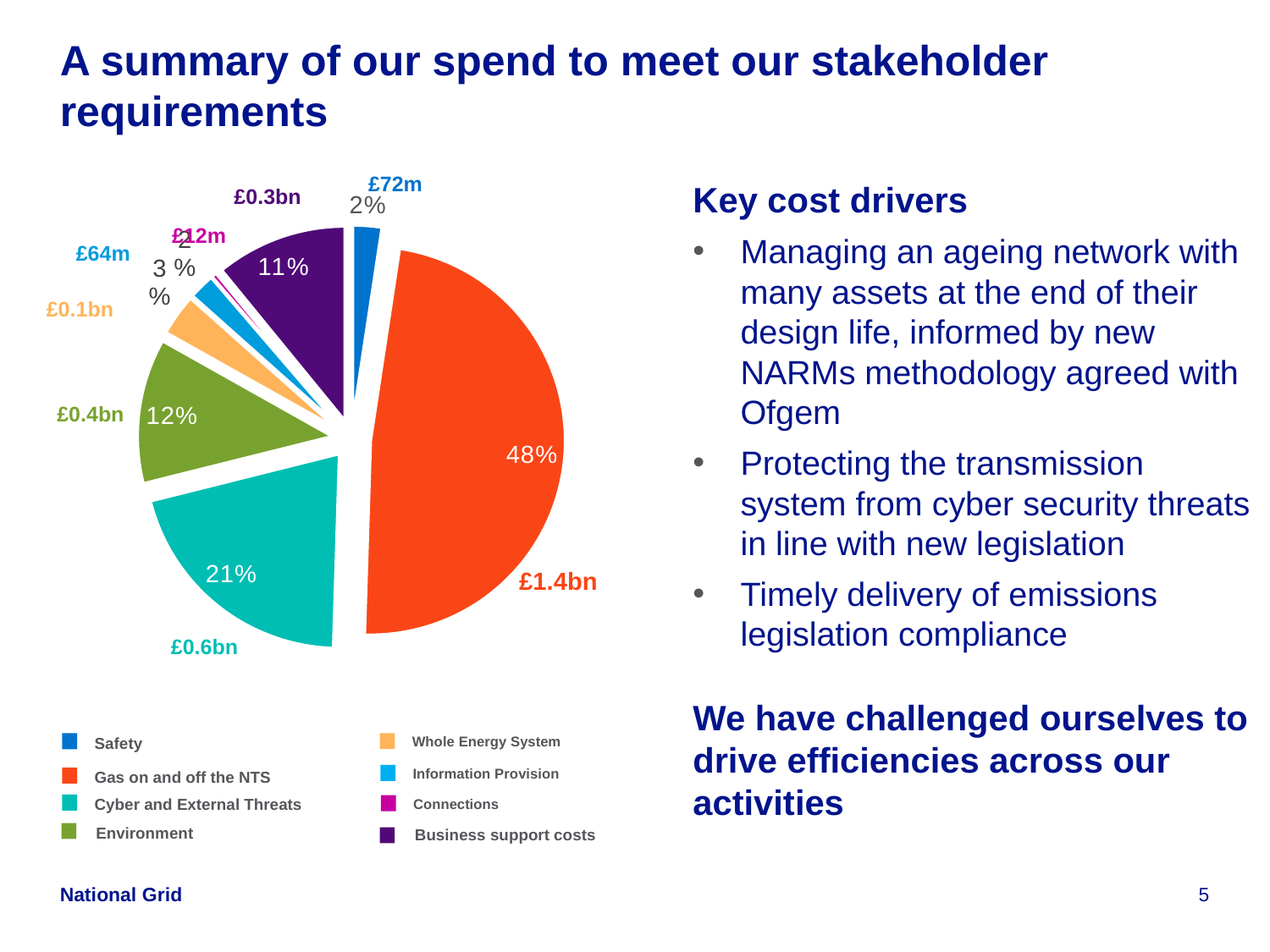
What is the spend value labelled for Gas on and off the NTS? £1.4bn What percentage of spend is shown for Business support costs? 11% Which has the larger share: Cyber and External Threats or Environment? Cyber and External Threats What percentage of spend is shown for Cyber and External Threats? 21% What is the spend value labelled for Safety? £72m What type of chart is shown on the slide? Pie chart How many categories does the legend of the pie chart list? 8 Which category has the largest share of the pie chart? Gas on and off the NTS What percentage of spend does the Gas on and off the NTS slice represent? 48% What is the difference in percentage points between the Gas on and off the NTS share and the Cyber and External Threats share? 27 percentage points What is the spend value labelled for Cyber and External Threats? £0.6bn What is the spend value labelled for Environment? £0.4bn